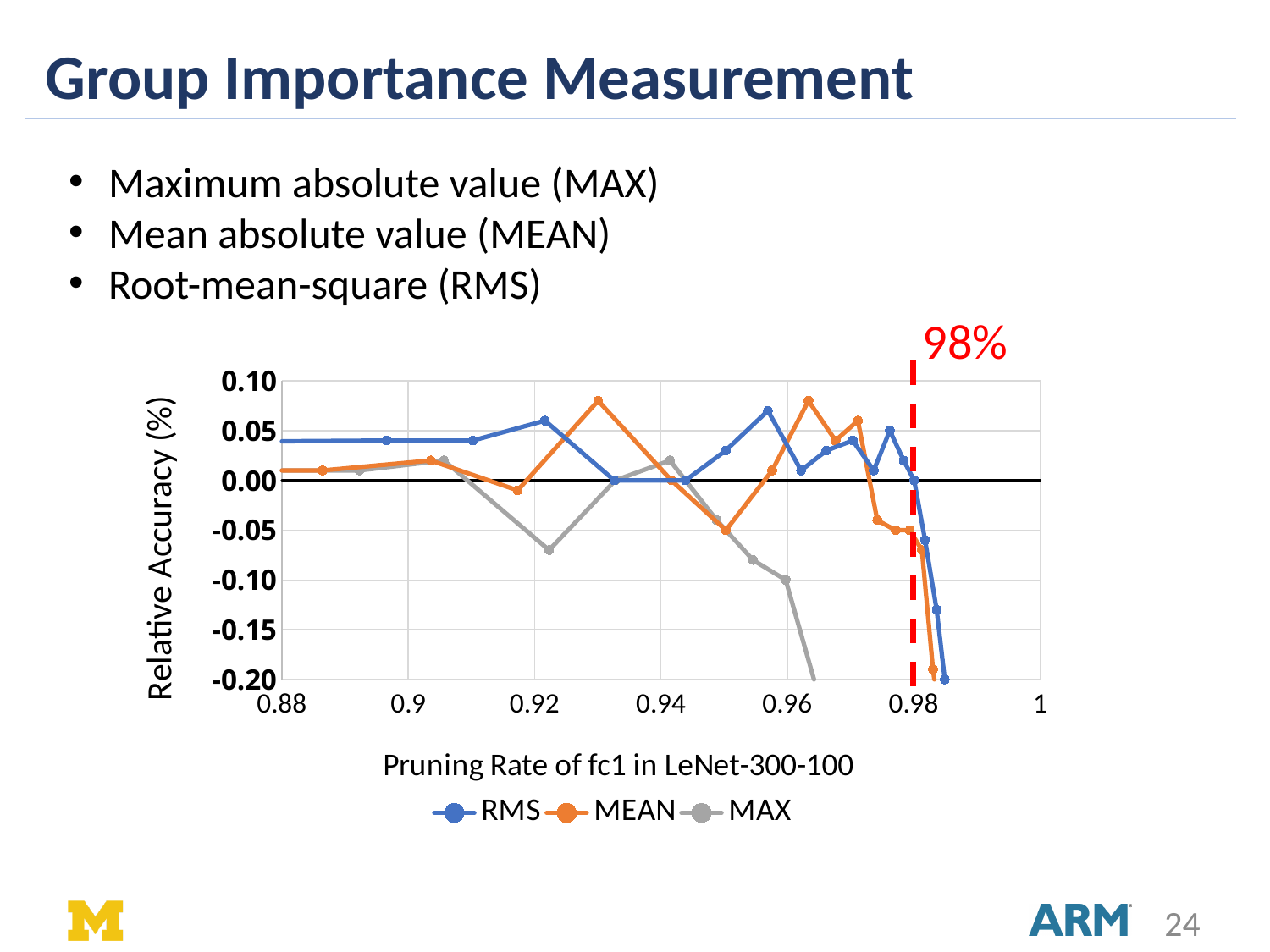
What kind of chart is shown on the slide? line chart Is the value of the MEAN series at a pruning rate of 0.88 greater or less than 0.00? greater How many series does the legend list? 3 Is the value of the MEAN series at a pruning rate of 0.93 greater or less than 0.05? greater At a pruning rate of 0.92, which series has the higher relative accuracy, RMS or MAX? RMS At a pruning rate of 0.93, which series has the higher relative accuracy, MEAN or RMS? MEAN Is the value of the RMS series at a pruning rate of 0.88 greater or less than 0.05? less What is the title of the x axis? Pruning Rate of fc1 in LeNet-300-100 Does the MAX series overall rise or fall as the pruning rate increases from 0.88 to 0.96? fall What are the three series named in the legend? RMS, MEAN, MAX Which series is the first to fall below -0.20 as the pruning rate increases? MAX